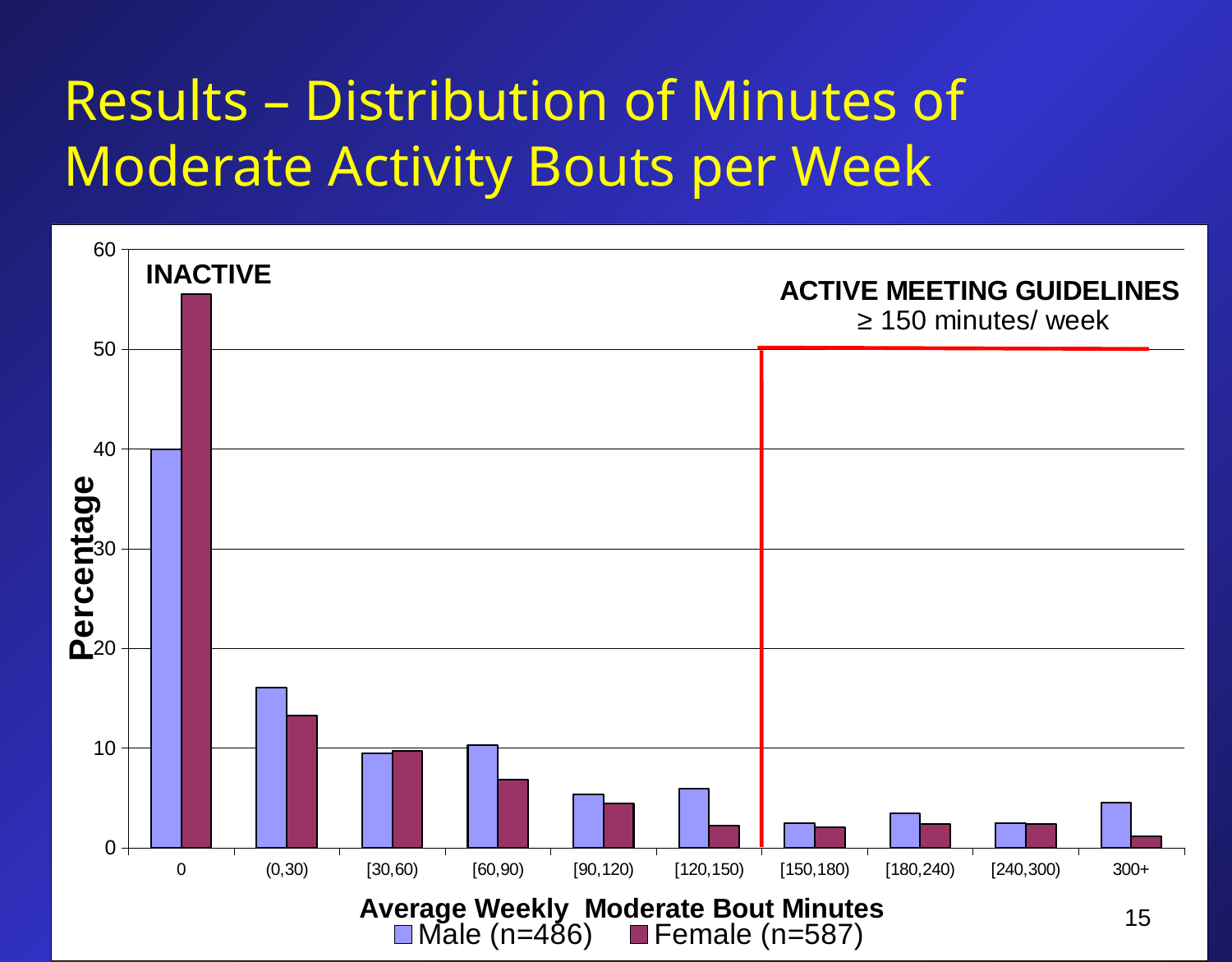
Is the Male (n=486) value for the (0,30) category greater or less than 10? greater In the 0 category, which is larger, the Male (n=486) bar or the Female (n=587) bar? Female (n=587) Is the Female (n=587) value for the 300+ category greater or less than 10? less What is the title of the y axis? Percentage What kind of chart is shown on the slide? bar chart What is the title of the x axis? Average Weekly Moderate Bout Minutes Which category has the highest bar for Male (n=486)? 0 In the (0,30) category, which is larger, the Male (n=486) bar or the Female (n=587) bar? Male (n=486) Which category has the highest bar for Female (n=587)? 0 Is the Female (n=587) value for the 0 category greater or less than 50? greater How many categories are shown along the x axis? 10 How many series does the legend list? 2